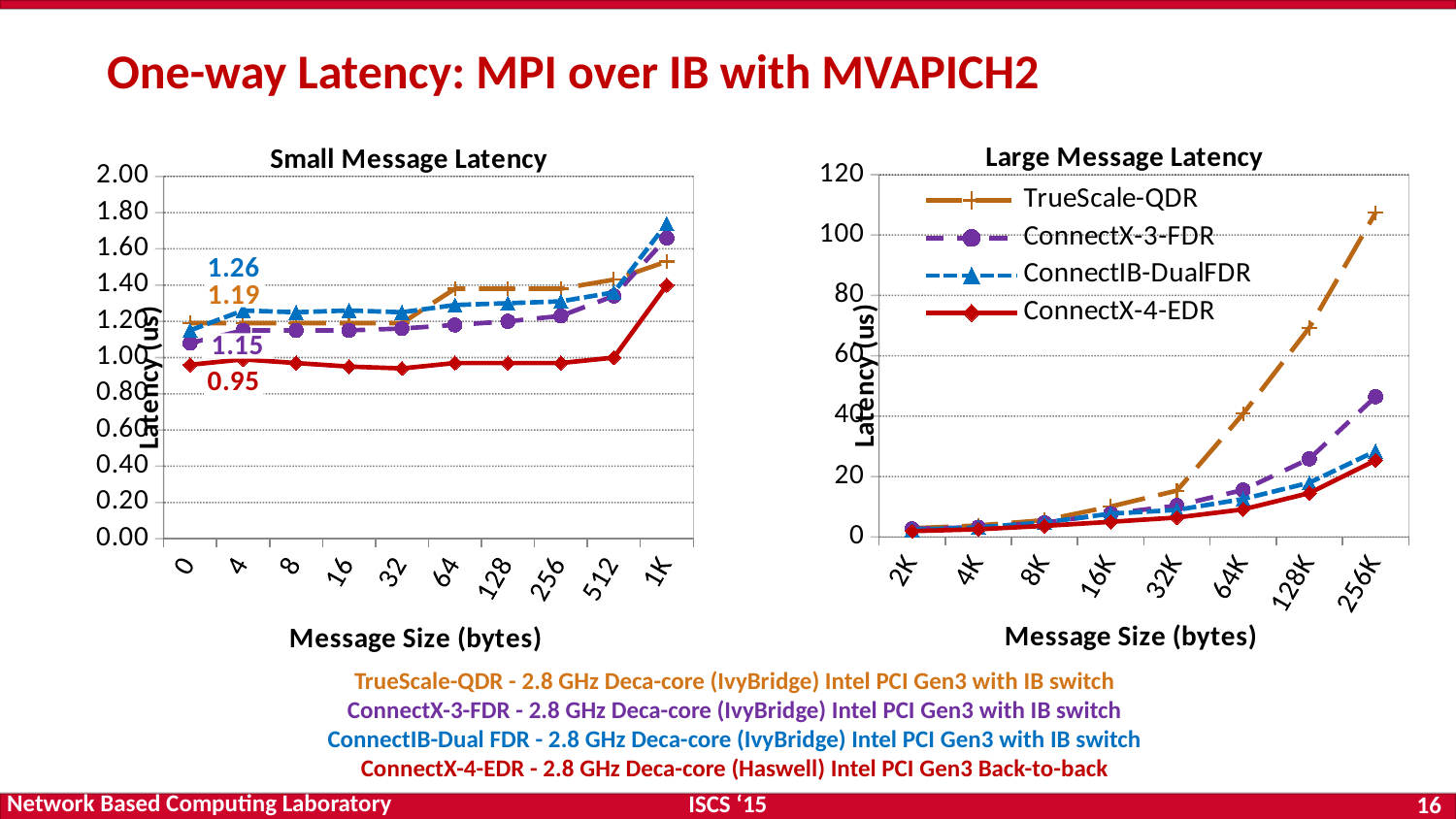
How many message sizes are plotted on the x axis of the Large Message Latency chart? 8 How many series does the legend on the Large Message Latency chart list? 4 On the Small Message Latency chart, what value is labeled for the ConnectIB-DualFDR series? 1.26 On the Small Message Latency chart, what value is labeled for the TrueScale-QDR series? 1.19 On the Large Message Latency chart, which series has the highest latency at 256K? TrueScale-QDR On the Large Message Latency chart, is the value for TrueScale-QDR at 256K greater or less than 100? greater On the Small Message Latency chart, what value is labeled for the ConnectX-3-FDR series? 1.15 On the Small Message Latency chart, what is the difference between the labeled values 1.26 (ConnectIB-DualFDR) and 0.95 (ConnectX-4-EDR)? 0.31 On the Small Message Latency chart, what value is labeled for the ConnectX-4-EDR series? 0.95 On the Small Message Latency chart, which labeled value is larger: TrueScale-QDR (1.19) or ConnectX-3-FDR (1.15)? TrueScale-QDR On the Large Message Latency chart, is the value for ConnectX-4-EDR at 128K greater or less than 20? less On the Small Message Latency chart, which series has the lowest latency at 1K? ConnectX-4-EDR